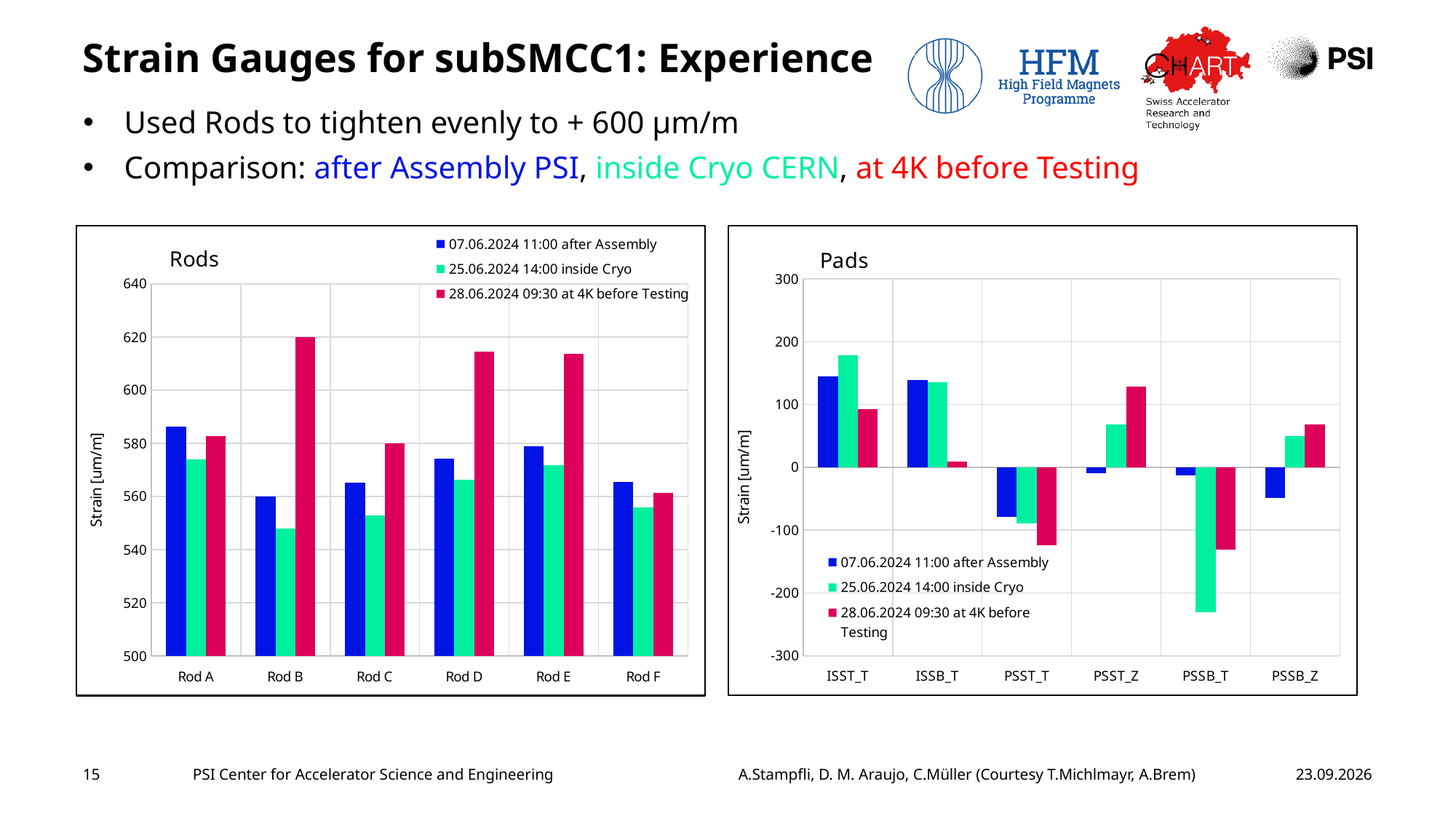
What kind of chart is the Rods chart? bar chart In the Rods chart, which rod has the highest value for the 28.06.2024 09:30 at 4K before Testing series? Rod B In the Pads chart, is the value for PSSB_T in the 25.06.2024 14:00 inside Cryo series greater or less than -200? less In the Rods chart, which is larger for the 07.06.2024 11:00 after Assembly series: Rod A or Rod B? Rod A How many rods are shown on the x axis of the Rods chart? 6 In the Pads chart, which category has the highest value for the 25.06.2024 14:00 inside Cryo series? ISST_T How many categories are shown on the x axis of the Pads chart? 6 In the Rods chart, is the value for Rod B in the 28.06.2024 09:30 at 4K before Testing series greater or less than 600? greater In the Pads chart, which category has the lowest value for the 25.06.2024 14:00 inside Cryo series? PSSB_T How many series does the legend of the Rods chart list? 3 In the Rods chart, which rod has the lowest value for the 25.06.2024 14:00 inside Cryo series? Rod B What is the y-axis label of the Pads chart? Strain [um/m]